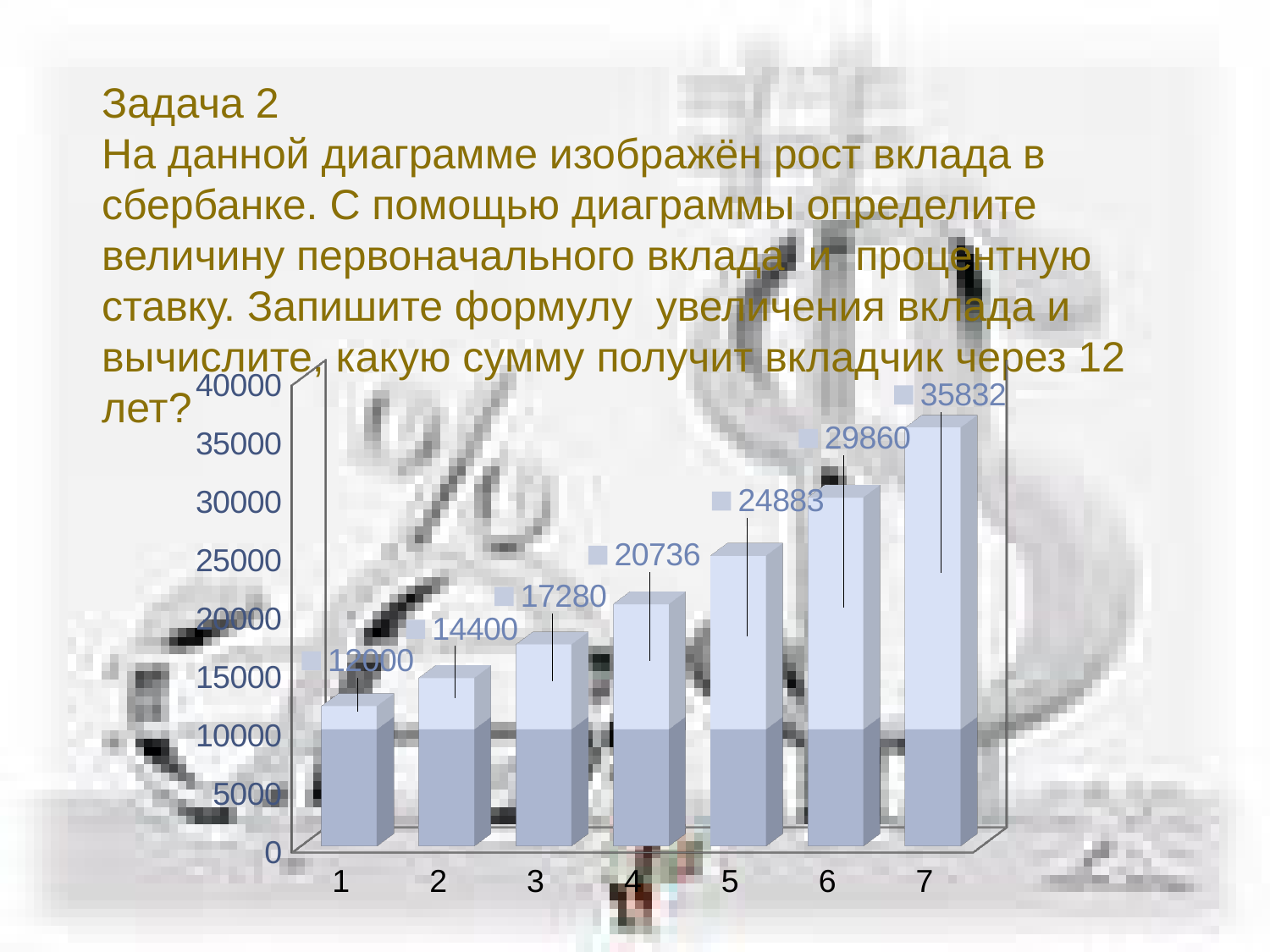
Which is larger, the value for category 3 or the value for category 5? category 5 Which category has the lowest value? 1 How many bars (categories) are plotted on the chart? 7 What is the value shown for category 1? 12000 What type of chart is shown on the slide? bar chart What is the difference between the values for category 2 and category 1? 2400 What is the value shown for category 7? 35832 Which category has the highest value? 7 What is the maximum value shown on the vertical axis? 40000 What is the value shown for category 4? 20736 What is the difference between the values for category 7 and category 6? 5972 Do the values rise or fall from category 1 to category 7? rise